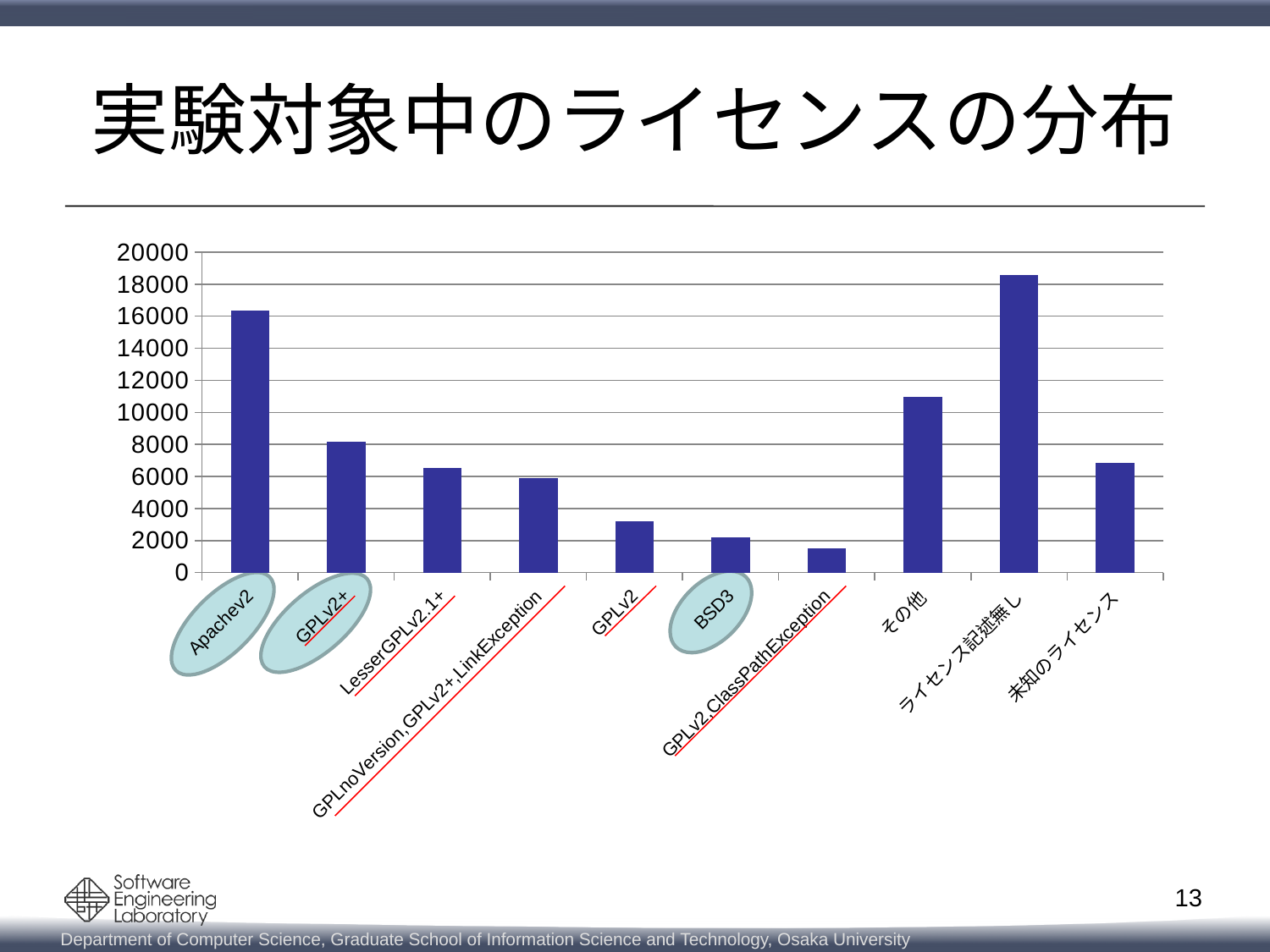
What is the title of the slide containing the chart? 実験対象中のライセンスの分布 How many categories (licenses) are plotted on the x axis? 10 Which category has the lowest bar? GPLv2,ClassPathException Which is larger, the value for Apachev2 or the value for その他? Apachev2 Is the value for その他 greater or less than 10000? greater Which is larger, the value for GPLv2 or the value for BSD3? GPLv2 Which category has the highest bar? ライセンス記述無し Is the value for BSD3 greater or less than 4000? less Is the value for ライセンス記述無し greater or less than 18000? greater What kind of chart is shown on the slide? bar chart